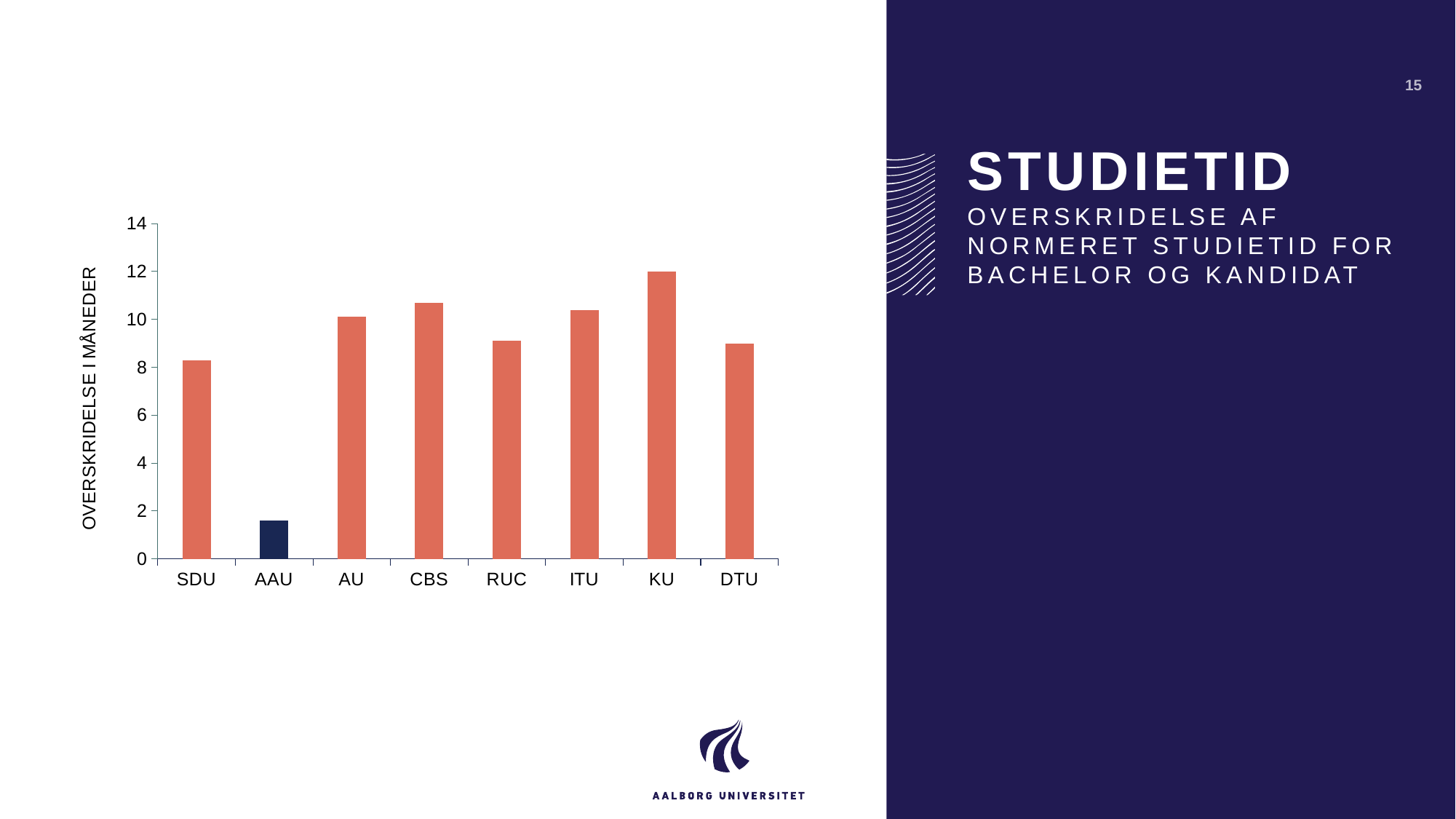
What kind of chart is shown on the slide? bar chart Is the value for RUC greater or less than 10? less Which university has the highest value in the chart? KU Is the value for AAU greater or less than 2? less Which has a larger value, KU or SDU? KU How many universities are shown on the x axis of the chart? 8 What is the value for KU in the chart? 12 Is the value for CBS greater or less than 10? greater Which has a larger value, CBS or RUC? CBS Which university has the lowest value in the chart? AAU What is the label on the y axis of the chart? OVERSKRIDELSE I MÅNEDER